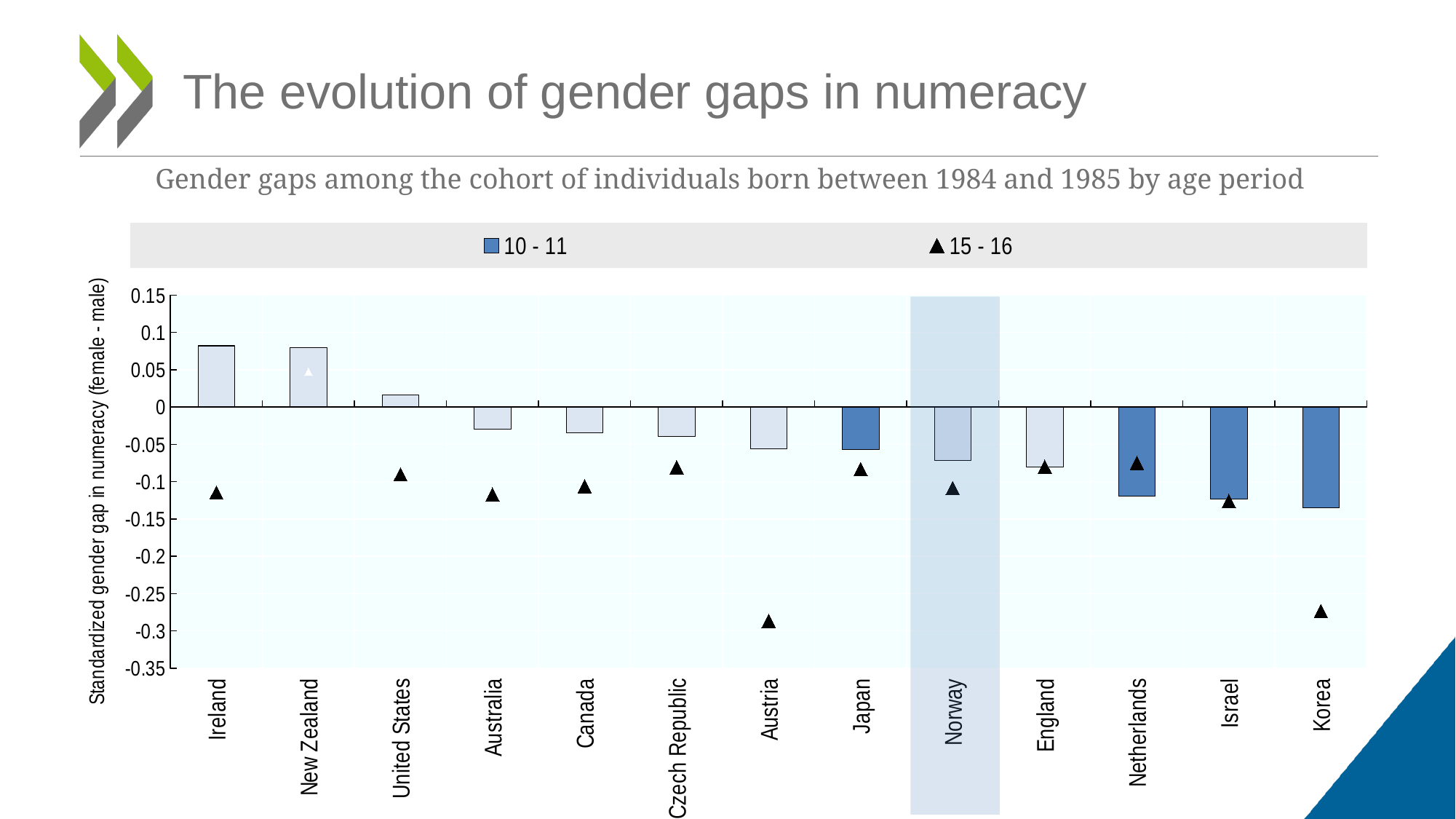
Is the 10 - 11 value for Korea greater or less than -0.1? less How many countries are shown on the x axis of the chart? 13 Is the 10 - 11 value for Ireland greater or less than 0.05? greater Which country has the highest 15 - 16 value? New Zealand What kind of chart is shown on the slide? Bar chart with triangle markers Is the 15 - 16 value for Austria greater or less than -0.25? less Do the 10 - 11 bar values generally rise or fall from left to right across the countries? fall Which country is highlighted with a shaded column in the chart? Norway Which country has the lowest 10 - 11 bar value? Korea Which is larger, the 15 - 16 value for Czech Republic or for Austria? Czech Republic How many series does the legend list? 2 Which two age periods are listed in the legend? 10 - 11 and 15 - 16